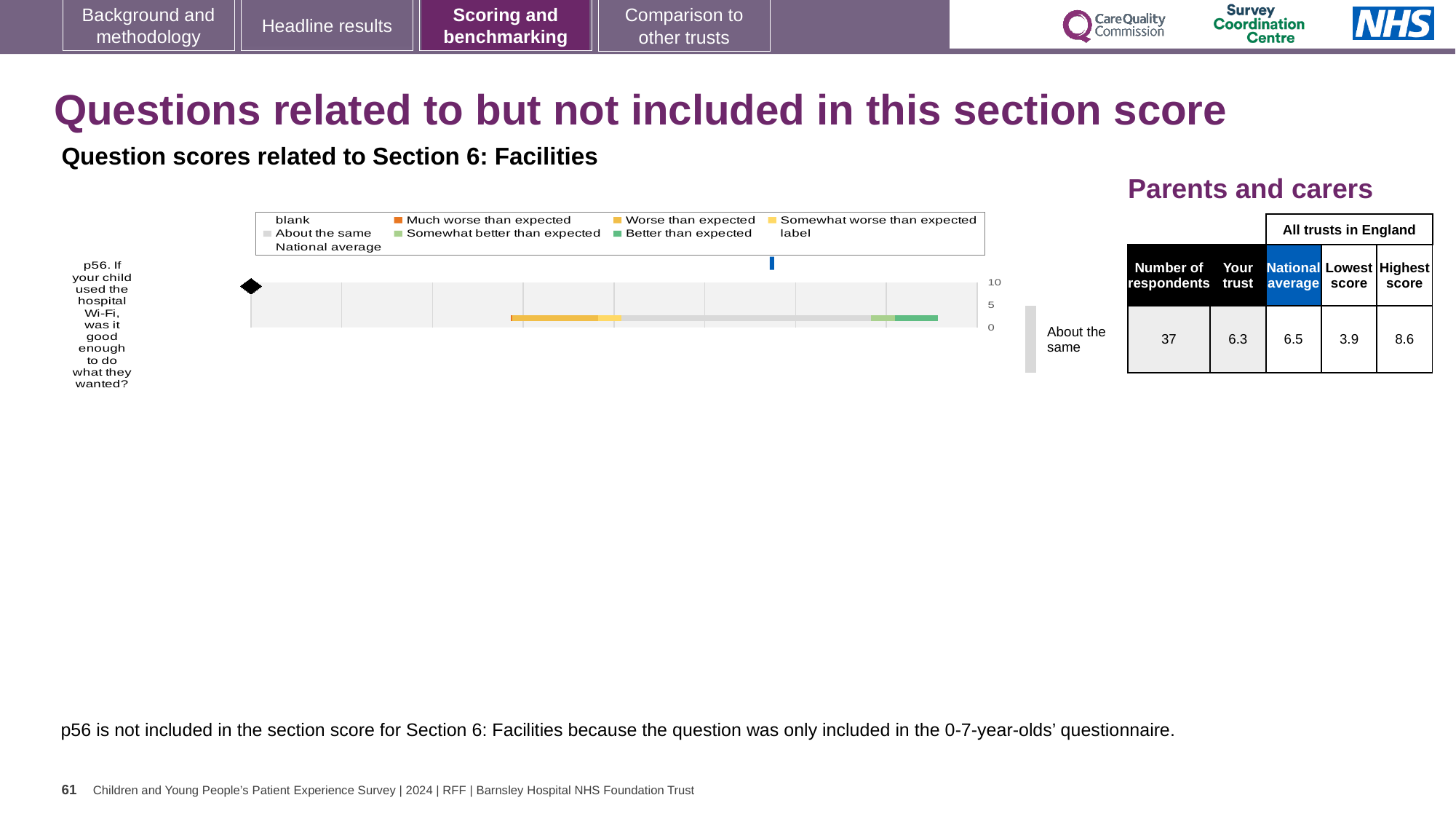
What is the difference between the highest score and the lowest score for p56? 4.7 What is the national average score for p56? 6.5 What kind of chart is used to show the p56 question score? bar chart How many respondents answered p56? 37 Which is larger for p56, the 'Your trust' score or the national average? National average What benchmark category is shown next to the chart for p56? About the same What is the lowest score among all trusts in England for p56? 3.9 What is the highest score among all trusts in England for p56? 8.6 What is the 'Your trust' score for p56? 6.3 What is the highest value shown on the chart's score axis? 10 Which question is plotted in the chart? p56. If your child used the hospital Wi-Fi, was it good enough to do what they wanted? How many questions are plotted in the chart? 1